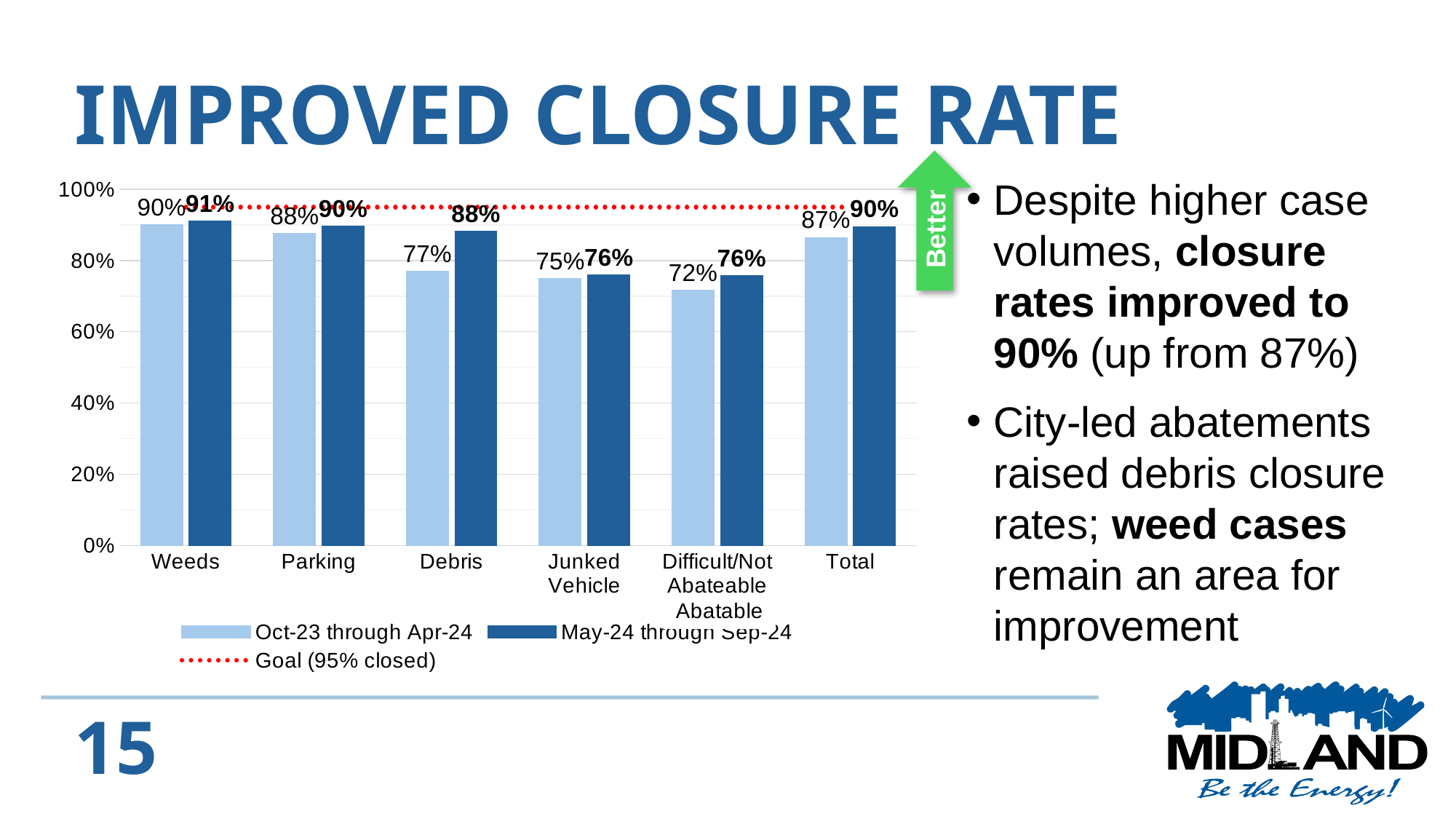
How many entries does the chart legend list? 3 Which category has the highest May-24 through Sep-24 closure rate? Weeds Is the Oct-23 through Apr-24 closure rate for Difficult/Not Abateable Abatable greater or less than 80%? less Which category has the lowest Oct-23 through Apr-24 closure rate? Difficult/Not Abateable Abatable What kind of chart is shown on the slide? Bar chart What is the May-24 through Sep-24 closure rate for Debris? 88% What is the Oct-23 through Apr-24 closure rate for Total? 87% By how many percentage points did the Debris closure rate increase from Oct-23 through Apr-24 to May-24 through Sep-24? 11 percentage points How many categories are shown on the x axis of the chart? 6 What goal value does the dotted red line in the chart represent? 95% closed What is the Oct-23 through Apr-24 closure rate for Junked Vehicle? 75% Which is larger: the May-24 through Sep-24 closure rate for Parking or for Junked Vehicle? Parking